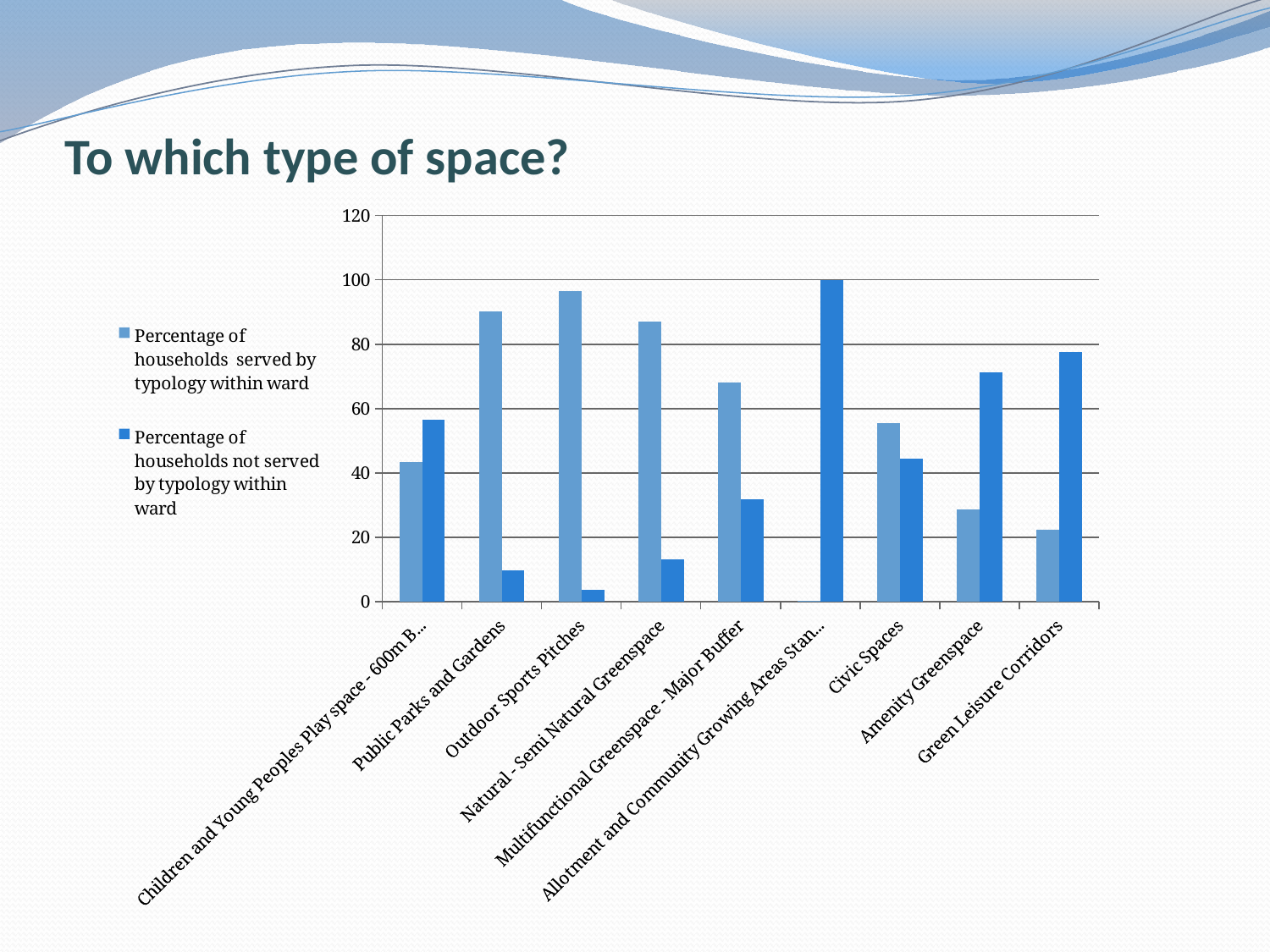
Which category has the lowest percentage of households not served by typology within ward? Outdoor Sports Pitches Which category has the highest percentage of households served by typology within ward? Outdoor Sports Pitches What kind of chart is shown on the slide? bar chart Is the percentage of households not served by typology for Multifunctional Greenspace - Major Buffer greater or less than 40? less What is the title of the slide containing the chart? To which type of space? For Public Parks and Gardens, which is larger: the percentage of households served or not served? served How many typology categories are shown on the x axis? 9 Which category has the highest percentage of households not served by typology within ward? Allotment and Community Growing Areas Stan... How many series does the legend list? 2 Is the percentage of households served by typology for Public Parks and Gardens greater or less than 80? greater Is the percentage of households served by typology for Green Leisure Corridors greater or less than 40? less For Amenity Greenspace, which is larger: the percentage of households served or not served? not served